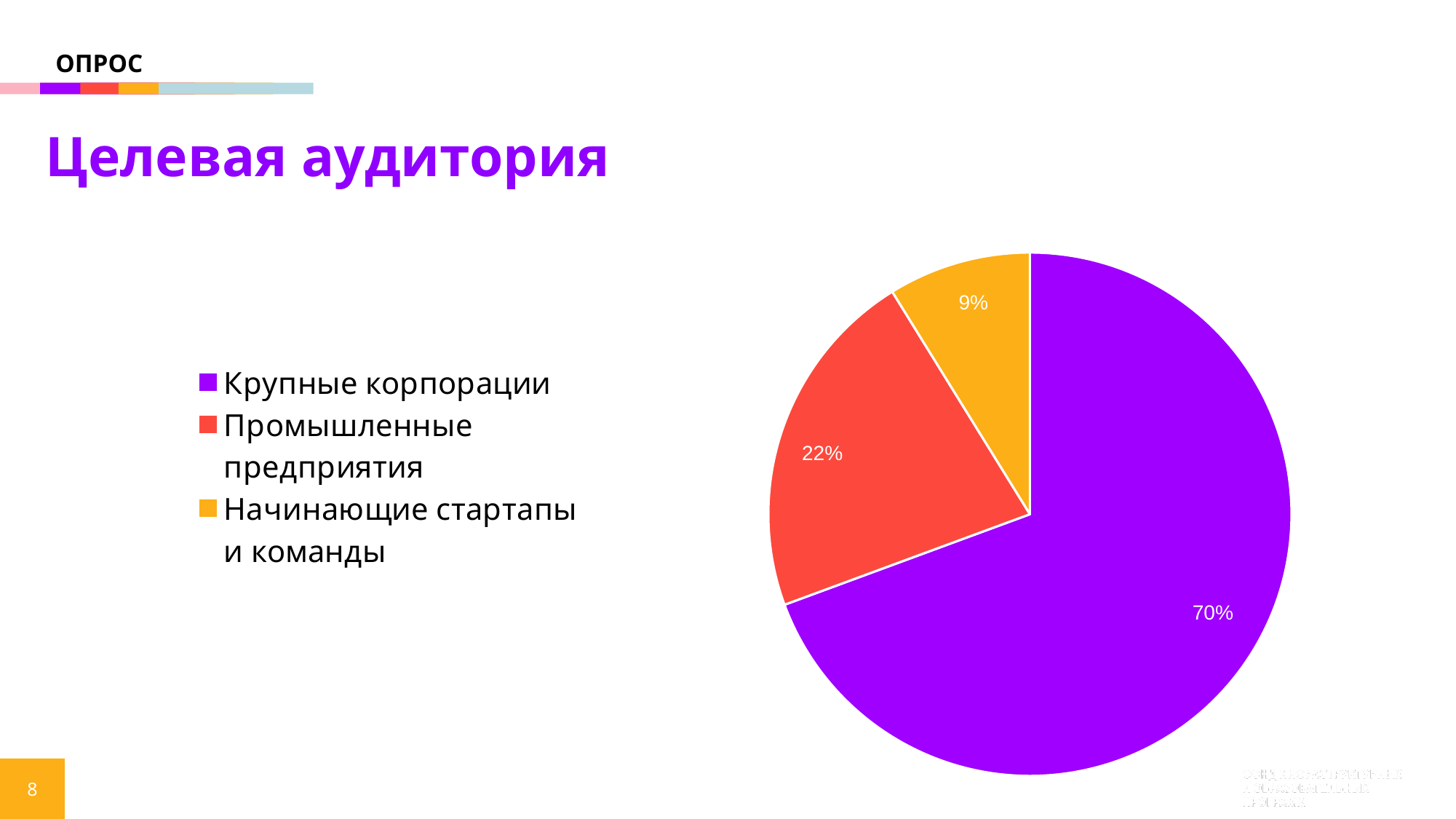
What colour is the slice for Начинающие стартапы и команды? orange Which category has the largest slice of the pie? Крупные корпорации What share of the pie does Промышленные предприятия have? 22% Which category has the smallest slice of the pie? Начинающие стартапы и команды How many entries does the legend list? 3 What share of the pie does Начинающие стартапы и команды have? 9% What share of the pie does Крупные корпорации have? 70% How many slices does the pie chart have? 3 What is the difference in percentage points between Крупные корпорации and Промышленные предприятия? 48 Which is larger: the slice for Промышленные предприятия or the slice for Начинающие стартапы и команды? Промышленные предприятия What is the difference in percentage points between Промышленные предприятия and Начинающие стартапы и команды? 13 What kind of chart is shown on the slide? pie chart